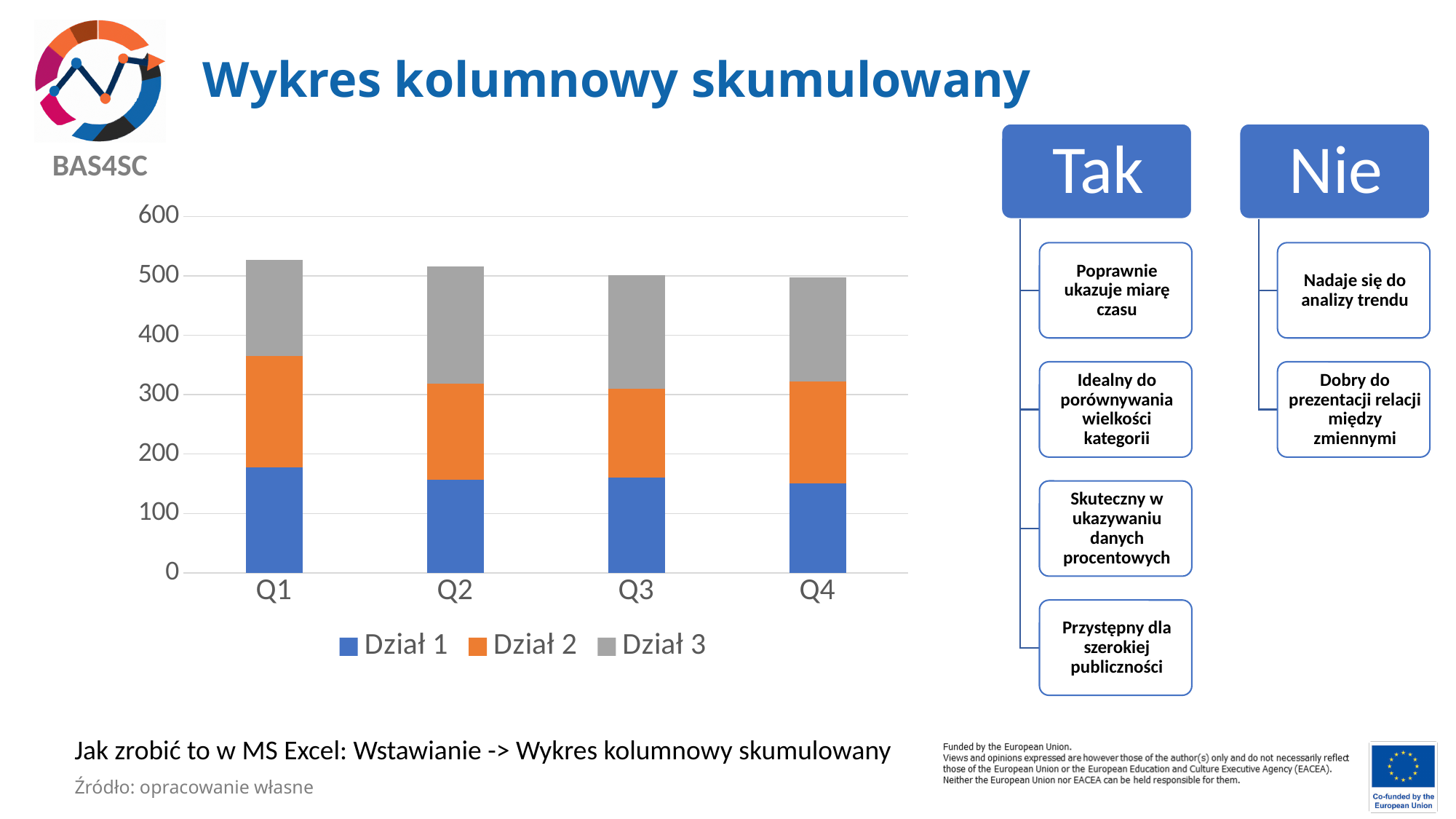
How many series does the chart legend list? 3 Which colour represents Dział 2 in the chart? Orange Is the value for Dział 1 in Q4 greater or less than 100? greater Is the total stacked value for Q1 greater or less than 500? greater How many categories are shown on the x axis of the chart? 4 What kind of chart is shown on the slide? Stacked bar chart Is the value for Dział 1 in Q1 greater or less than 200? less Which is larger, the Dział 1 value for Q1 or for Q2? Q1 Which is larger, the total stacked bar for Q1 or for Q4? Q1 What are the series names listed in the chart legend? Dział 1, Dział 2, Dział 3 Which quarter has the highest total stacked bar? Q1 Do the total stacked bar heights rise or fall from Q1 to Q4? fall